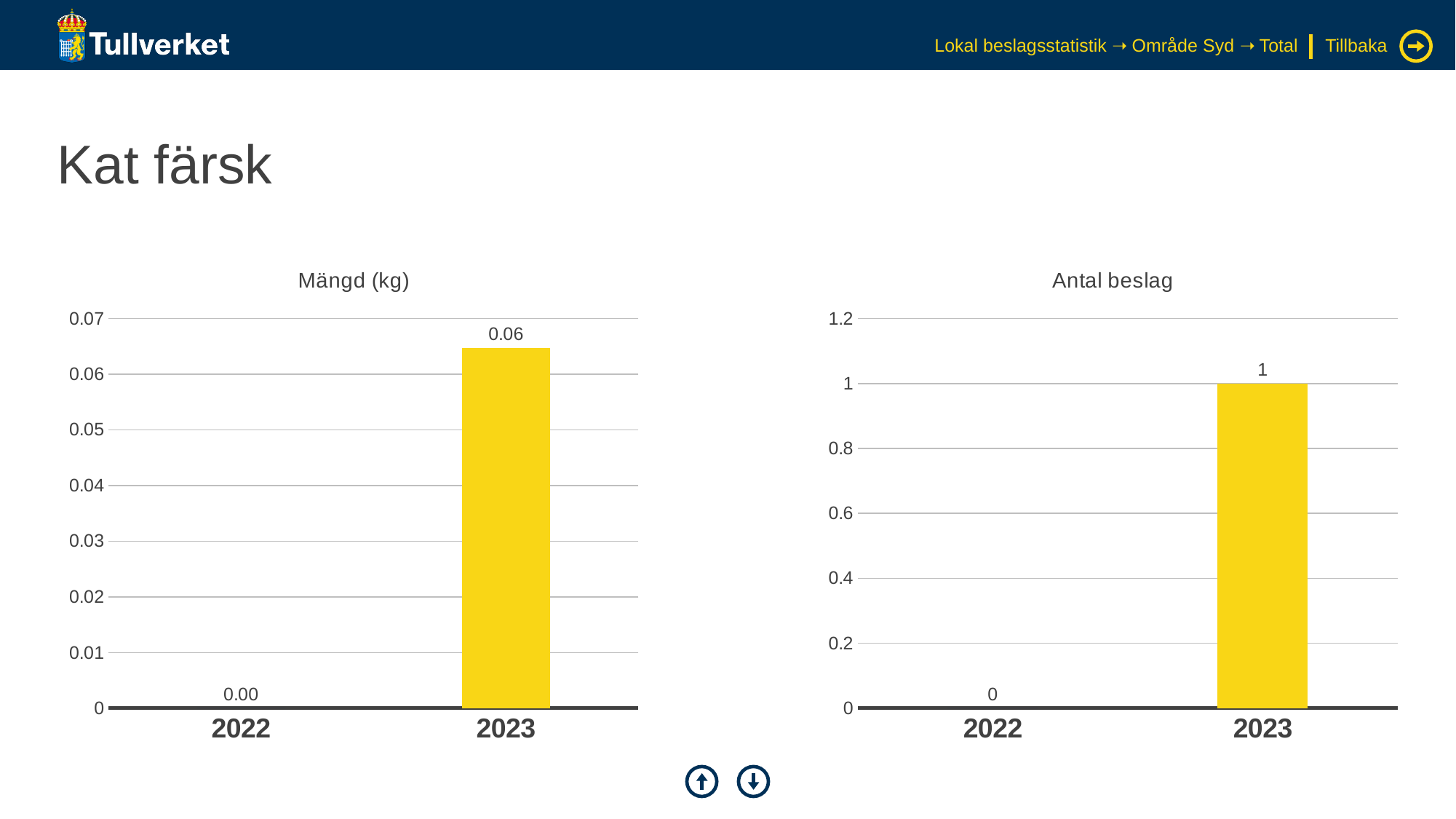
In the 'Antal beslag' chart, what is the value for 2022? 0 In the 'Antal beslag' chart, what is the difference between the 2023 and 2022 values? 1 In the 'Mängd (kg)' chart, what is the value for 2023? 0.06 How many years are shown on the x axis of the 'Mängd (kg)' chart? 2 In the 'Mängd (kg)' chart, what is the value for 2022? 0.00 In the 'Antal beslag' chart, what is the value for 2023? 1 In the 'Antal beslag' chart, which year has the lowest value? 2022 In the 'Antal beslag' chart, which year has the larger value, 2022 or 2023? 2023 In the 'Mängd (kg)' chart, do the values rise or fall from 2022 to 2023? Rise In the 'Mängd (kg)' chart, which year has the highest value? 2023 In the 'Mängd (kg)' chart, what is the difference between the 2023 and 2022 values? 0.06 What kind of chart is the 'Antal beslag' chart? Bar chart